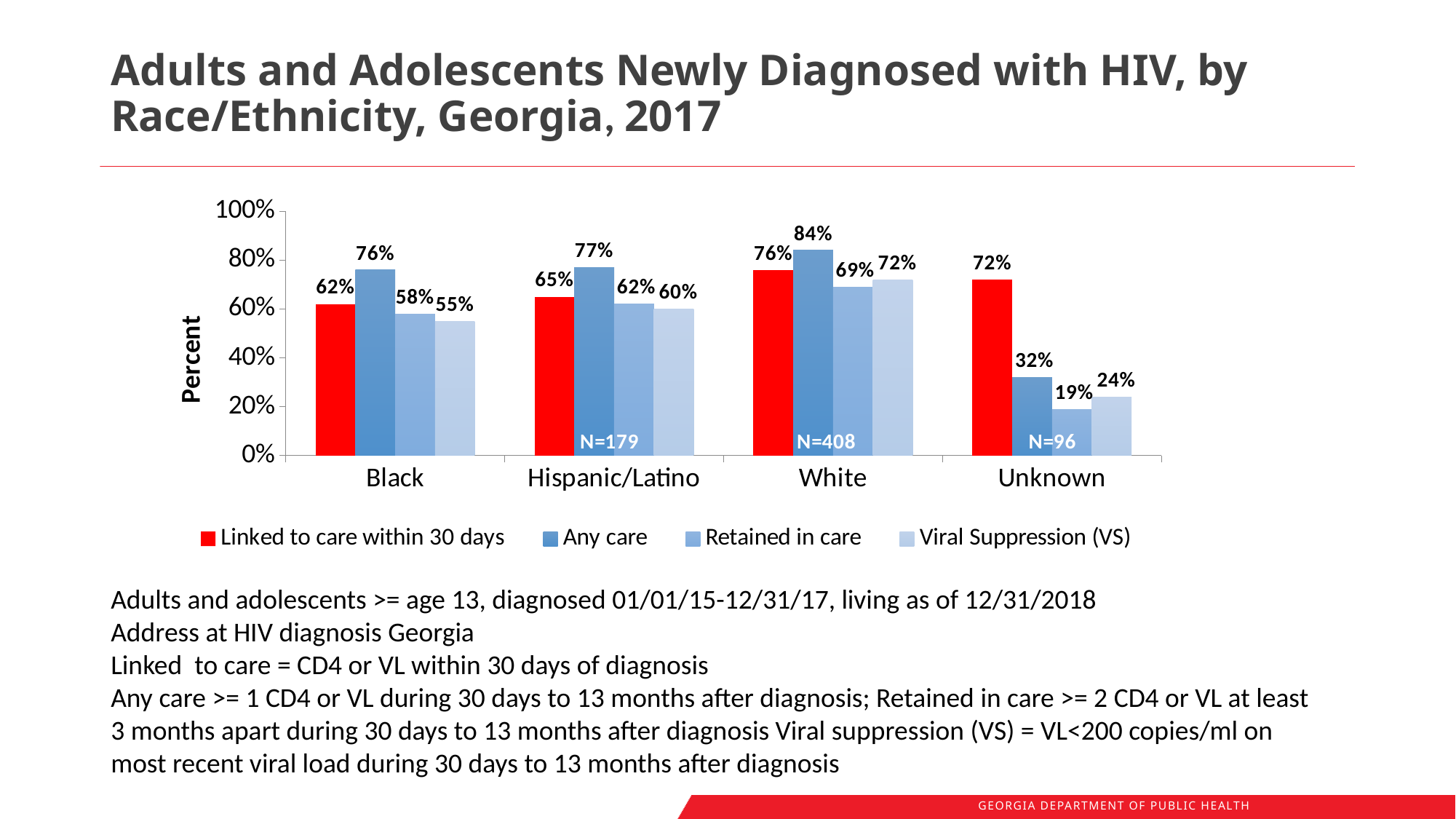
How many series does the legend list? 4 Which race/ethnicity group has the lowest value for Retained in care? Unknown What is the value for Viral Suppression (VS) in the Unknown group? 24% Which is larger for the Hispanic/Latino group: Retained in care or Viral Suppression (VS)? Retained in care What is the value for Any care in the White group? 84% What is the N shown for the White group? N=408 What kind of chart is shown on the slide? Bar chart Is the value for Linked to care within 30 days in the Unknown group greater or less than 60%? greater How many race/ethnicity categories are shown on the x axis? 4 What is the difference between the Any care and Retained in care values for the Black group? 18% Which race/ethnicity group has the highest value for Any care? White What is the value for Linked to care within 30 days in the Hispanic/Latino group? 65%